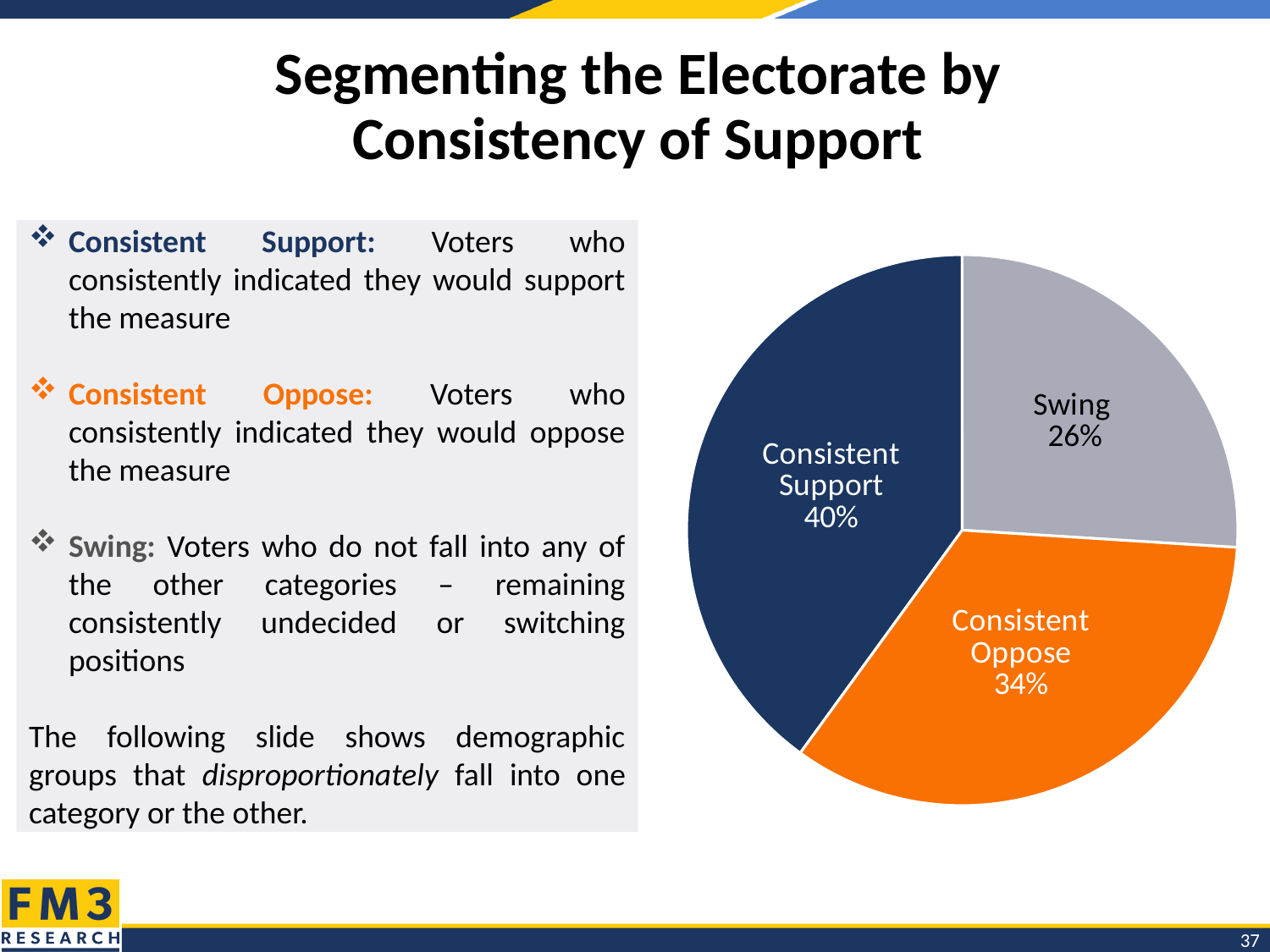
Which is larger, the Consistent Oppose share or the Swing share? Consistent Oppose What kind of chart is shown on the slide? Pie chart Which segment of the pie chart is the smallest? Swing What colour is the Swing segment of the pie chart? Grey How many segments does the pie chart have? 3 What share of the electorate is labelled Consistent Oppose? 34% What share of the electorate is labelled Consistent Support? 40% What is the difference in percentage points between Consistent Oppose and Swing? 8 Which segment of the pie chart is the largest? Consistent Support What colour is the Consistent Oppose segment of the pie chart? Orange What is the difference in percentage points between Consistent Support and Consistent Oppose? 6 What share of the electorate is labelled Swing? 26%